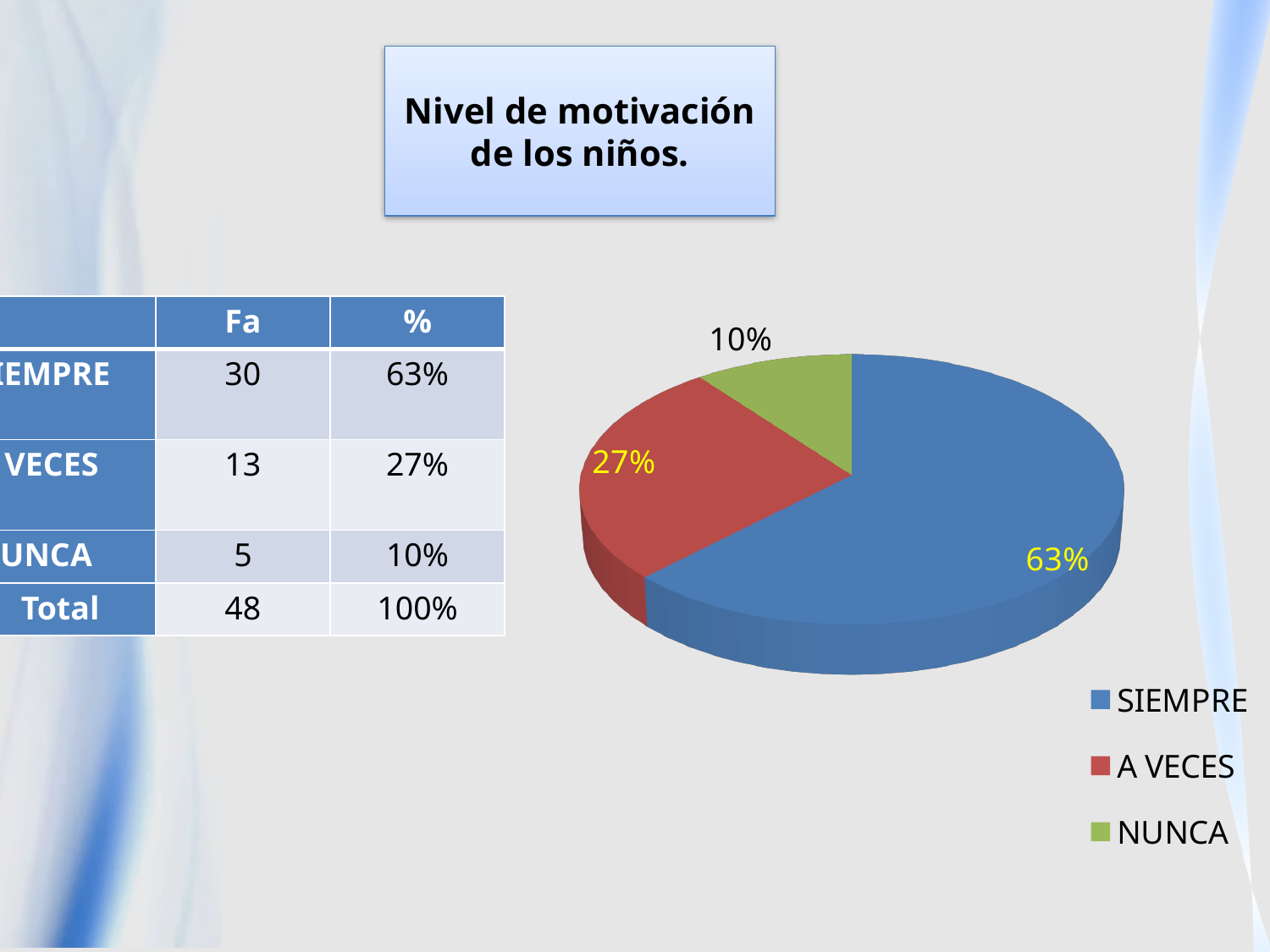
How many slices does the pie chart have? 3 Which category has the largest slice in the pie chart? SIEMPRE Which slice is larger, A VECES or NUNCA? A VECES What percentage does the A VECES slice show in the pie chart? 27% What colour is the SIEMPRE slice in the pie chart? Blue What percentage does the SIEMPRE slice show in the pie chart? 63% What type of chart is shown on the slide? Pie chart What percentage does the NUNCA slice show in the pie chart? 10% What is the difference in percentage points between the SIEMPRE and A VECES slices? 36 What is the difference in percentage points between the A VECES and NUNCA slices? 17 How many entries does the legend list? 3 Which category has the smallest slice in the pie chart? NUNCA